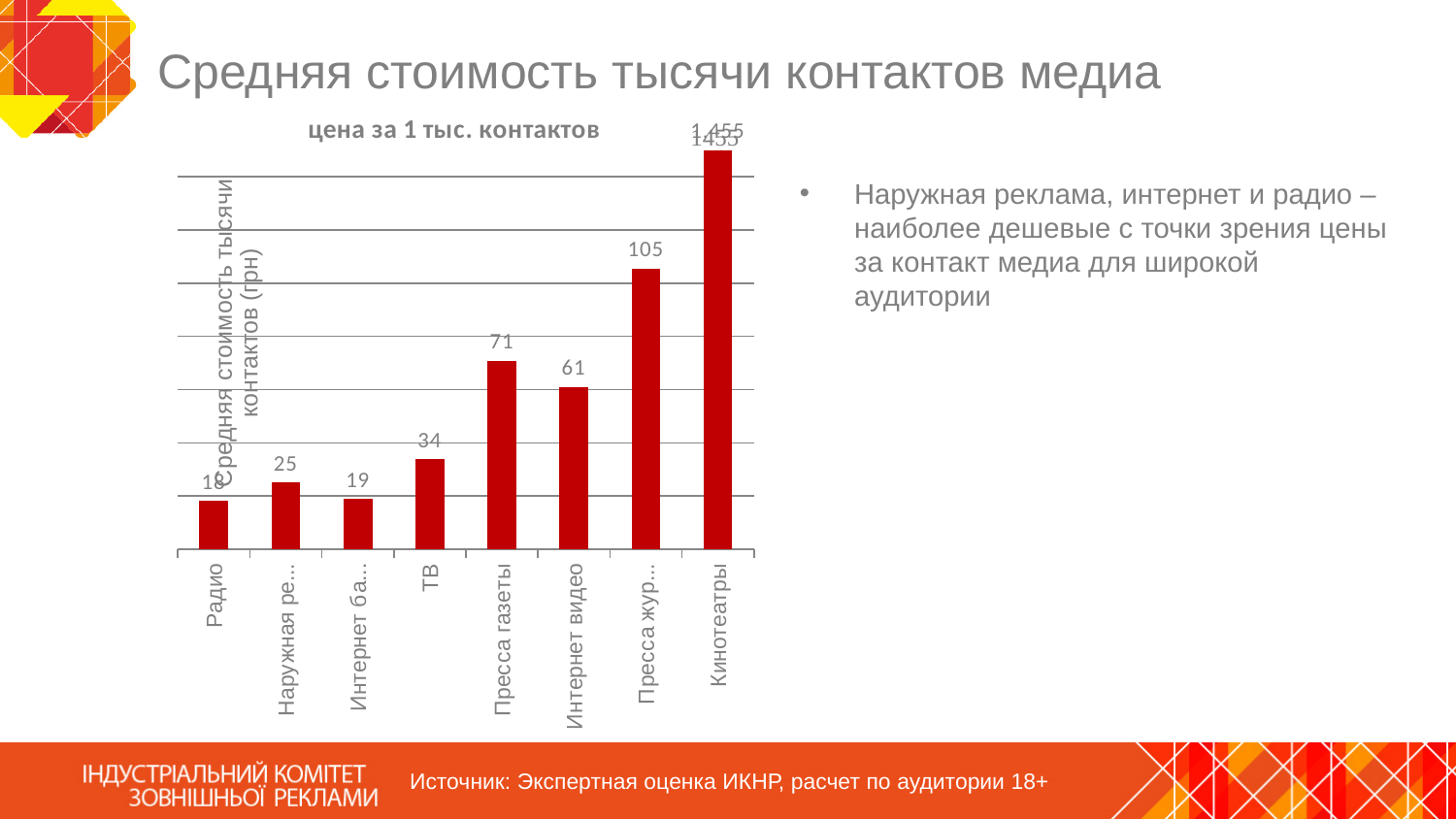
How many bars are shown in the chart? 8 Which category has the highest value in the chart? Кинотеатры What is the difference between the values for ТВ and Радио? 16 What is the value for Интернет видео? 61 What is the value for Пресса газеты? 71 What is the title of the chart? цена за 1 тыс. контактов What is the value for Радио? 18 What kind of chart is shown on the slide? Bar chart What is the difference between the values for Пресса газеты and Интернет видео? 10 What is the value for ТВ? 34 What is the value for Кинотеатры in the chart 'цена за 1 тыс. контактов'? 1455 Which is larger, the value for Пресса газеты or the value for Интернет видео? Пресса газеты